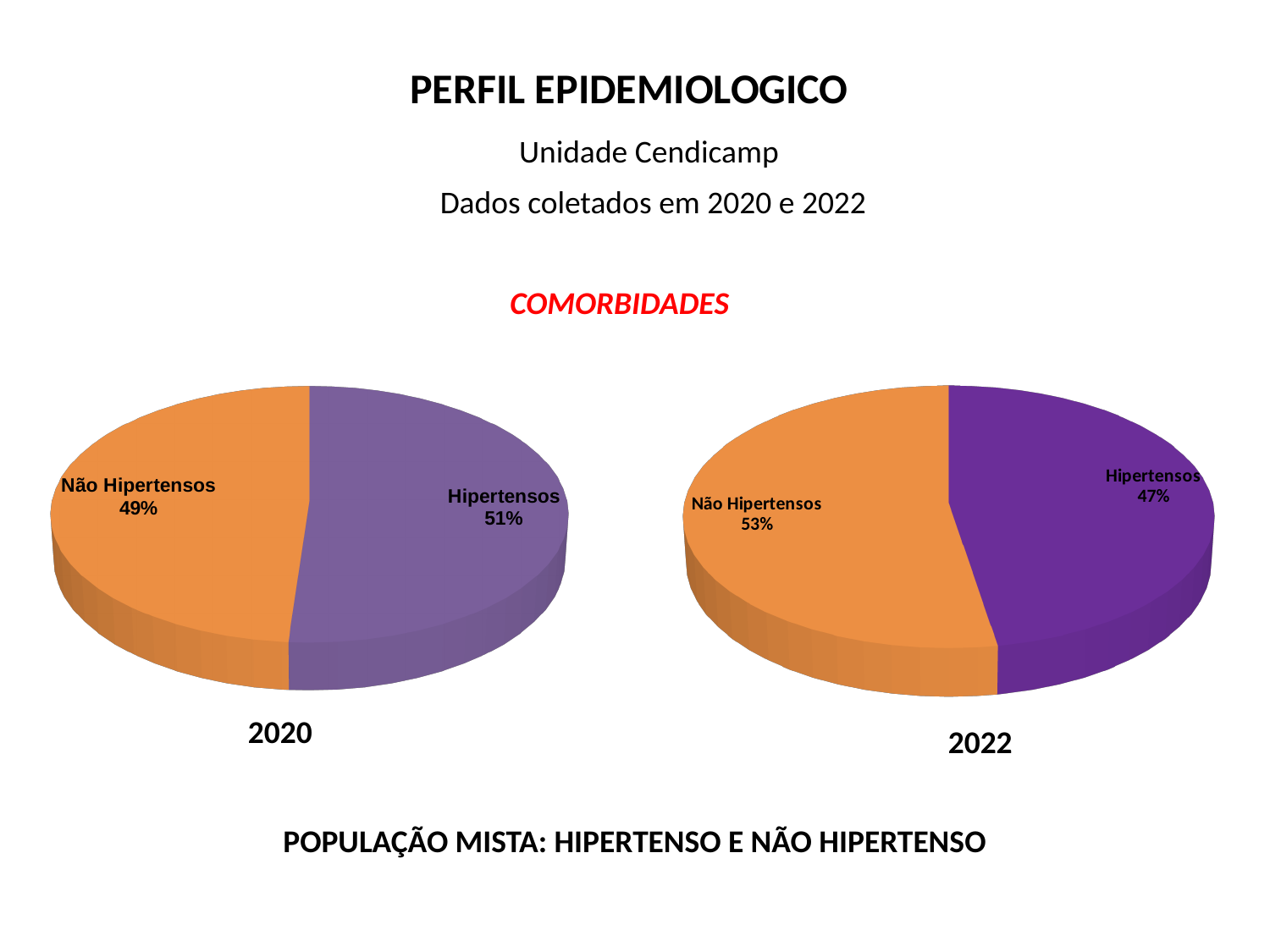
In the 2022 pie chart, which slice is the smallest? Hipertensos In the 2020 pie chart, what is the difference between the Hipertensos and Não Hipertensos shares? 2% In the 2022 pie chart, what share is labelled for Não Hipertensos? 53% Which is larger: the Hipertensos share in 2020 or the Hipertensos share in 2022? 2020 How many slices does the 2022 pie chart have? 2 What colour is the Não Hipertensos slice in the 2020 pie chart? Orange In the 2020 pie chart, what share is labelled for Hipertensos? 51% In the 2020 pie chart, which slice is the largest? Hipertensos In the 2020 pie chart, what share is labelled for Não Hipertensos? 49% In the 2022 pie chart, what share is labelled for Hipertensos? 47% What kind of chart is used for the 2020 data? Pie chart In the 2022 pie chart, what is the difference between the Não Hipertensos and Hipertensos shares? 6%